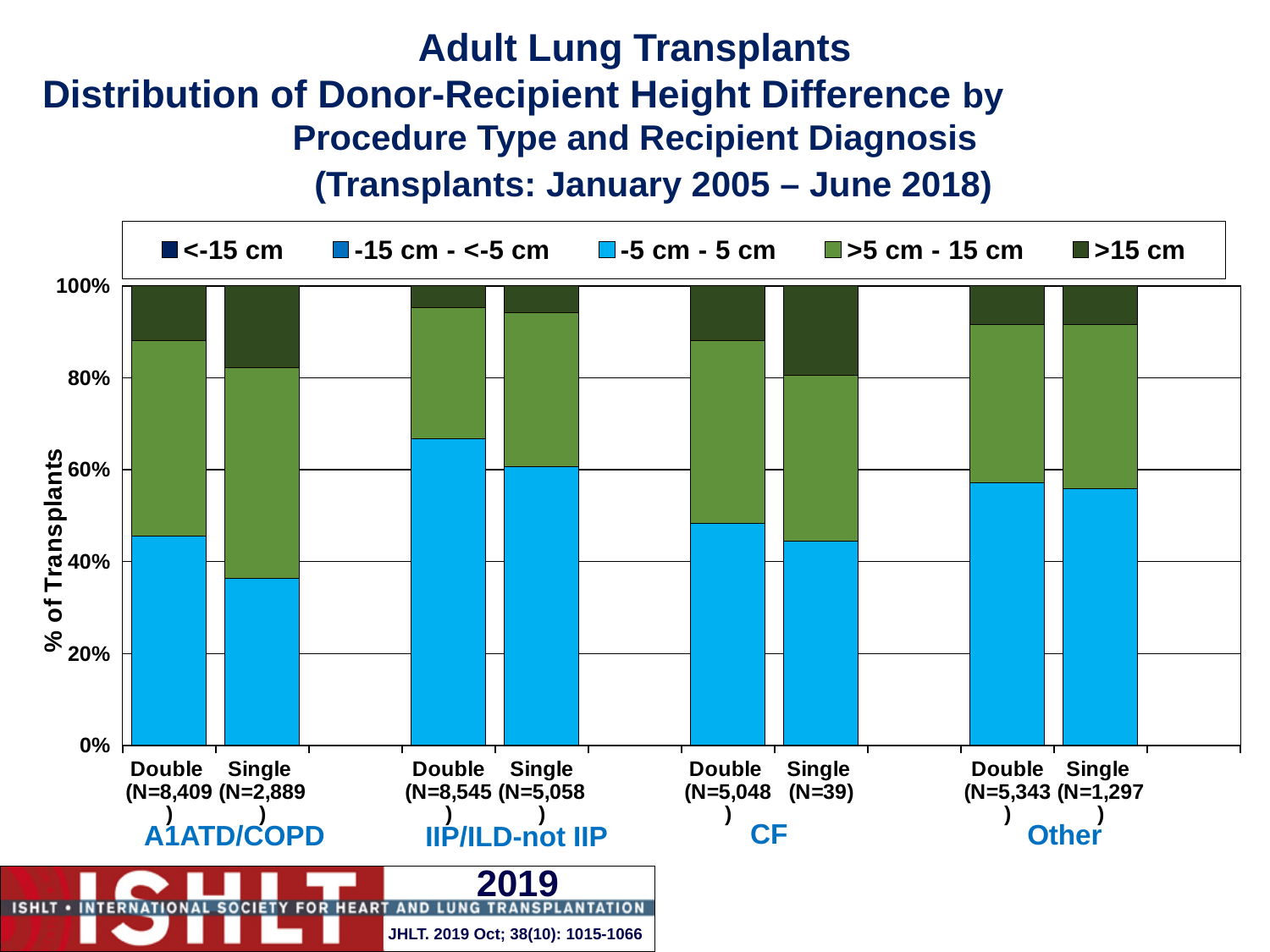
Which bar has the largest -5 cm - 5 cm segment? IIP/ILD-not IIP Double What is the N shown for the CF Single bar? N=39 Which bar has the smallest -5 cm - 5 cm segment? A1ATD/COPD Single Is the -5 cm - 5 cm share for IIP/ILD-not IIP Double greater or less than 60%? greater What kind of chart is shown on the slide? Stacked bar chart Which bar has the largest >15 cm segment? CF Single How many series does the legend list? 5 Which legend entry is shown in light blue? -5 cm - 5 cm How many bars are plotted in the chart? 8 Is the -5 cm - 5 cm share for A1ATD/COPD Single greater or less than 40%? less What is the total height of the Double bar for CF? 100% For A1ATD/COPD, which procedure type has the larger -5 cm - 5 cm segment, Double or Single? Double